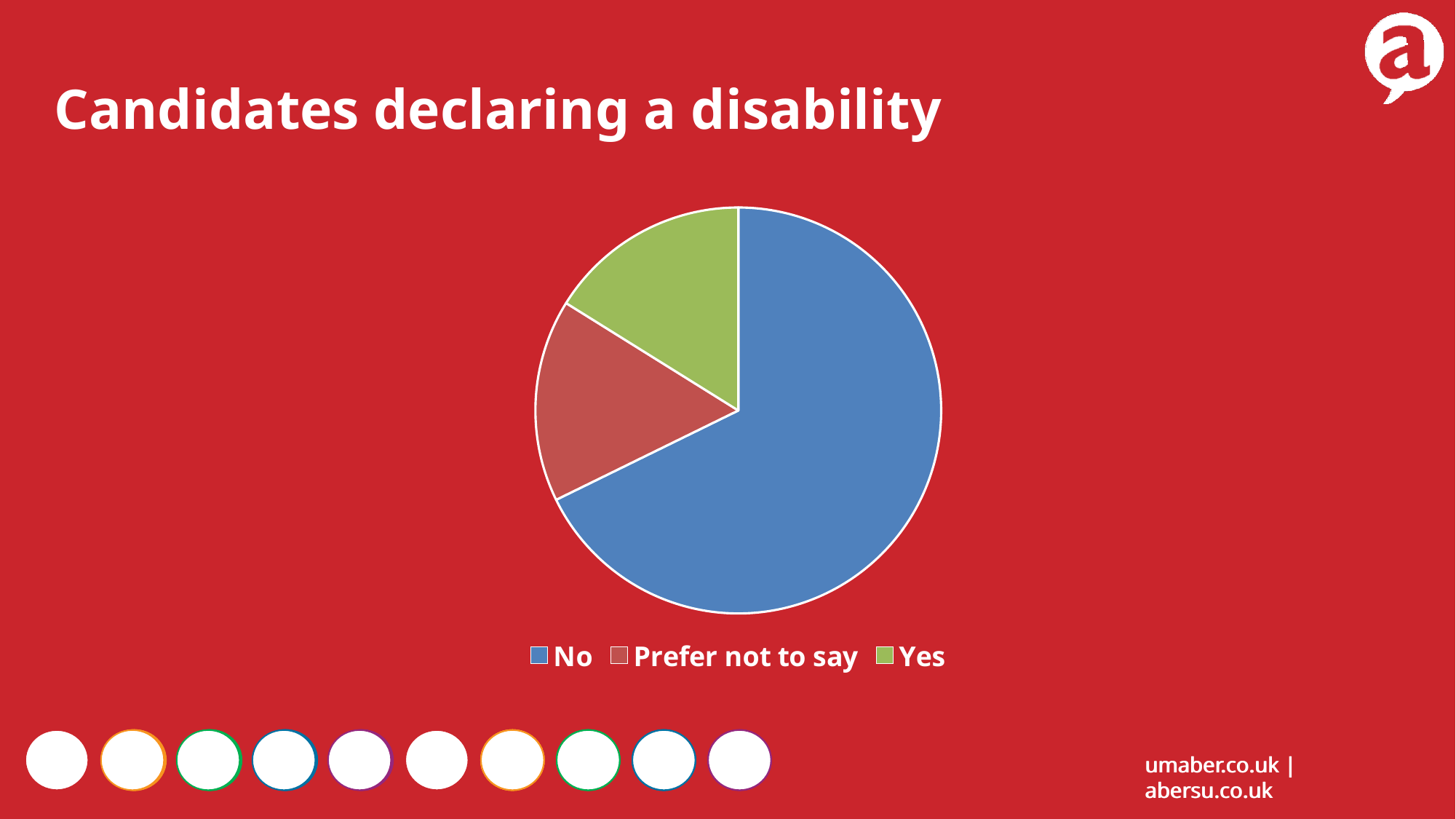
Which slice is larger, No or Prefer not to say? No Which slice is larger, No or Yes? No How many entries does the legend list? 3 Which category has the largest slice of the pie? No How many categories does the pie chart have? 3 What kind of chart is shown on the slide? pie chart What is the title of the chart? Candidates declaring a disability What colour is the slice for No? blue